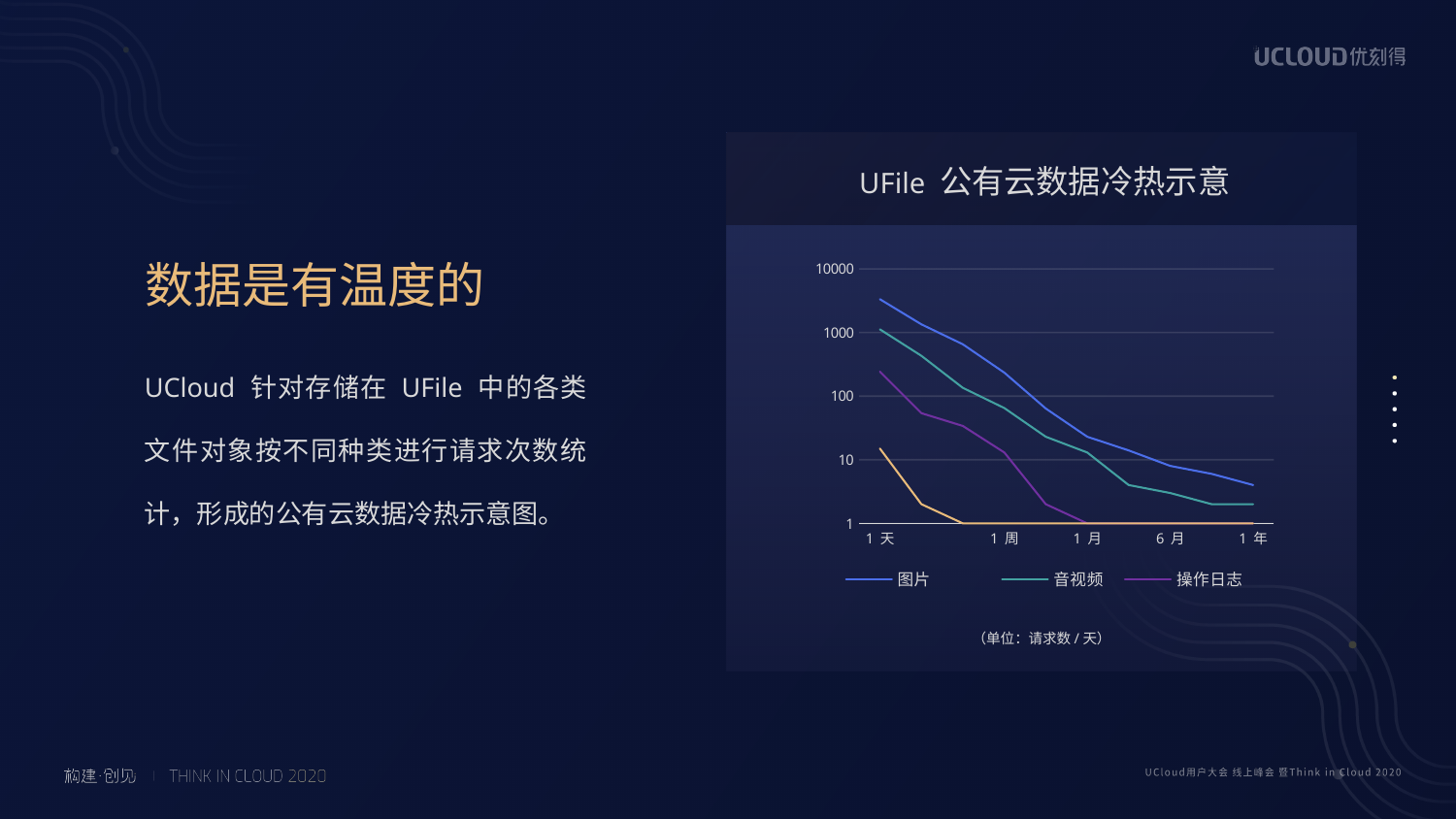
Do the values for 图片 rise or fall along the x axis from 1 天 to 1 年? fall How many categories are shown on the x axis of the chart? 5 Is the value for 音视频 at 1 年 greater or less than 10? less What kind of chart is shown on the slide? line chart How many series does the chart legend list? 3 At 1 天, which is larger: the value for 图片 or the value for 音视频? 图片 What is the title of the chart? UFile 公有云数据冷热示意 Is the value for 操作日志 at 1 天 greater or less than 100? greater Which legend series has the lowest value at 1 月? 操作日志 Which legend series has the highest value at 1 年? 图片 Is the value for 图片 at 1 年 greater or less than 10? less